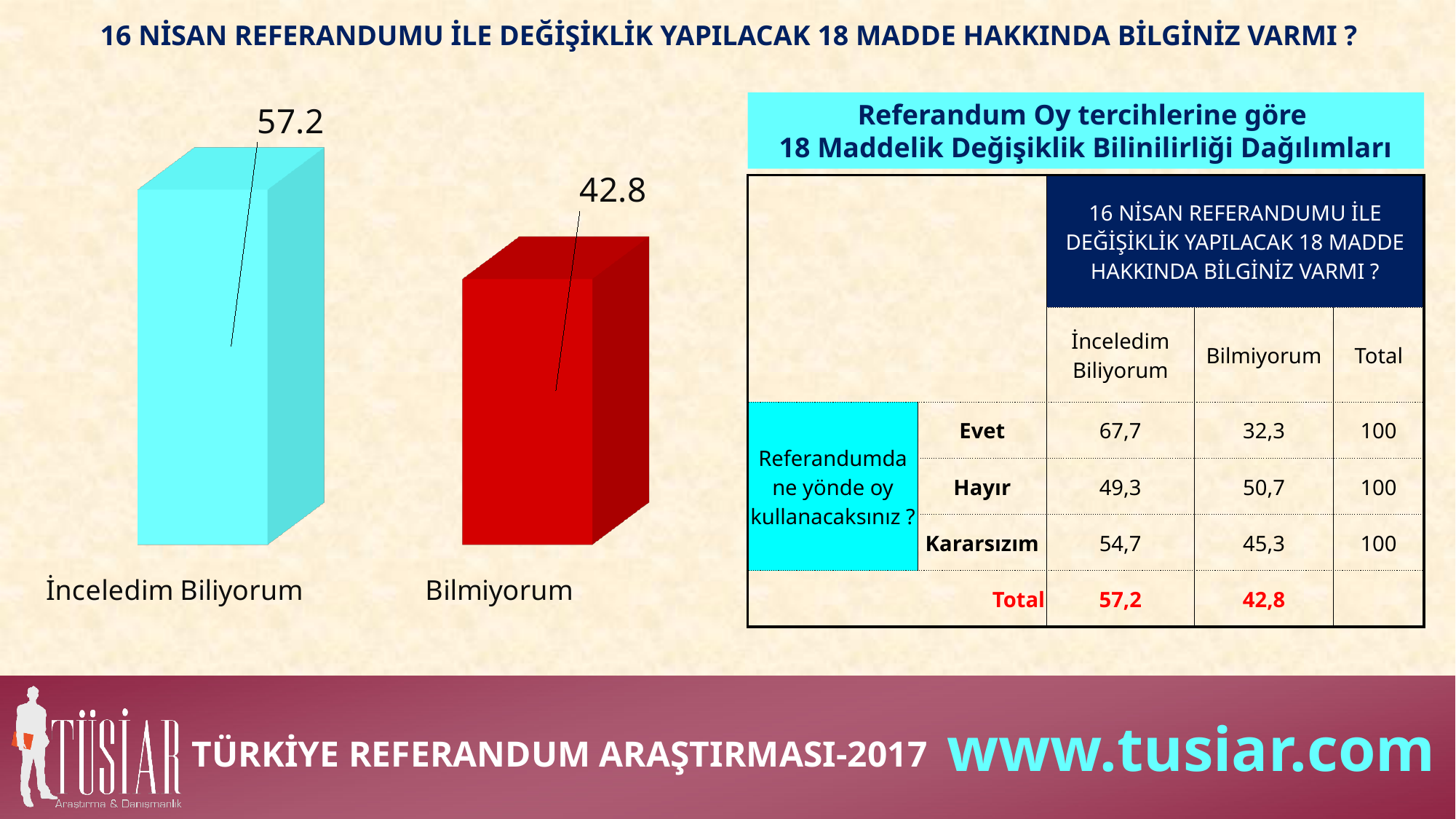
Which is larger in the bar chart, İnceledim Biliyorum or Bilmiyorum? İnceledim Biliyorum What is the total of the two bar values in the bar chart? 100 What is the value for İnceledim Biliyorum in the bar chart? 57.2 What kind of chart is shown on the left of the slide? Bar chart What is the difference between the values for İnceledim Biliyorum and Bilmiyorum in the bar chart? 14.4 How many bars are shown in the bar chart? 2 Which category has the highest value in the bar chart? İnceledim Biliyorum What colour is the bar for Bilmiyorum in the bar chart? Red What colour is the bar for İnceledim Biliyorum in the bar chart? Light blue What is the value for Bilmiyorum in the bar chart? 42.8 Which category has the lowest value in the bar chart? Bilmiyorum